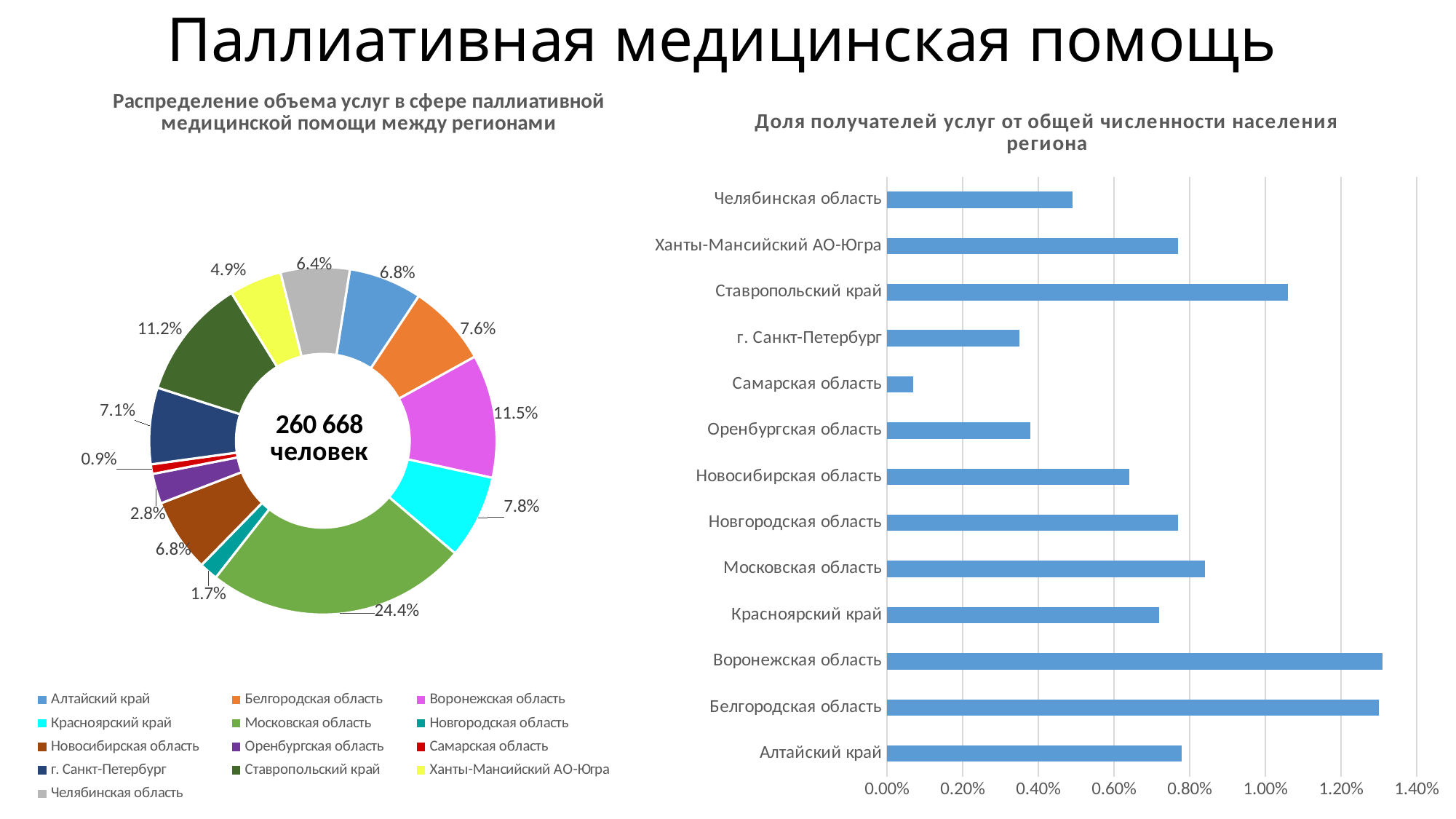
In the right bar chart, which region has the lowest value? Самарская область What kind of chart is the left chart, 'Распределение объема услуг в сфере паллиативной медицинской помощи между регионами'? Doughnut (pie) chart In the left doughnut chart, what share does Московская область have? 24.4% In the left doughnut chart, what is the difference between the shares of Ставропольский край and Ханты-Мансийский АО-Югра? 6.3% What total number of people is shown in the centre of the left doughnut chart? 260 668 человек In the left doughnut chart, which region has the smallest share? Самарская область How many regions are listed in the legend of the left doughnut chart? 13 In the left doughnut chart, which region has the largest share? Московская область In the left doughnut chart, which has a larger share: Красноярский край or Белгородская область? Красноярский край What kind of chart is the right chart, 'Доля получателей услуг от общей численности населения региона'? Bar chart In the left doughnut chart, what share does Воронежская область have? 11.5% In the right bar chart, is the value for Ставропольский край greater or less than 1.00%? greater